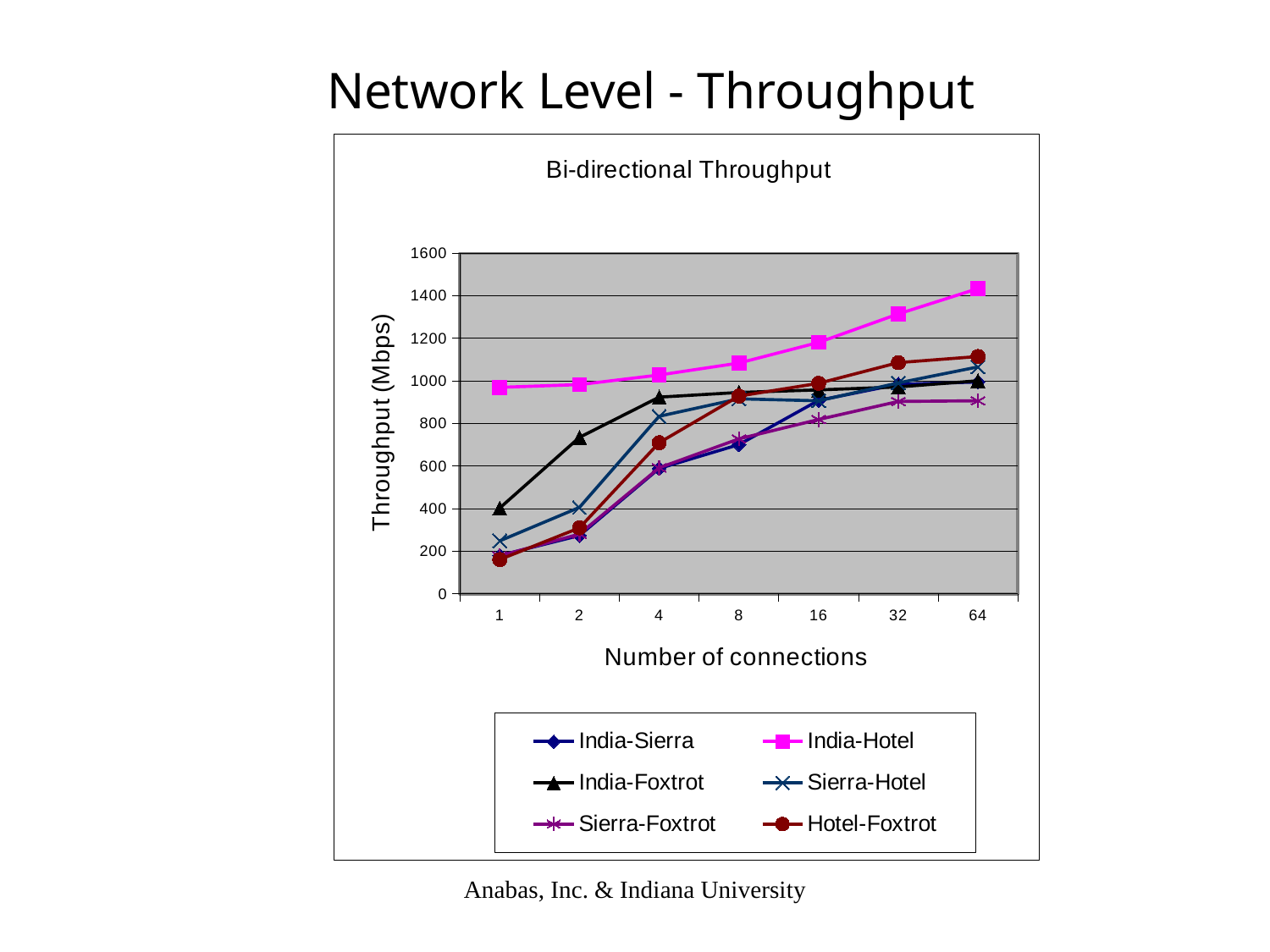
At 2 connections, which has the higher throughput, India-Foxtrot or Sierra-Hotel? India-Foxtrot Is the throughput for India-Hotel at 64 connections greater or less than 1200? greater What is the title of the chart? Bi-directional Throughput Which series has the highest throughput at 64 connections? India-Hotel What is the label of the y axis? Throughput (Mbps) Is the throughput for India-Foxtrot at 1 connection greater or less than 600? less Does the throughput for India-Hotel rise or fall as the number of connections increases? rise Is the throughput for Hotel-Foxtrot at 64 connections greater or less than 1000? greater What kind of chart is shown on the slide? line chart Which series has the lowest throughput at 64 connections? Sierra-Foxtrot How many series does the legend list? 6 How many values for number of connections are shown on the x axis? 7